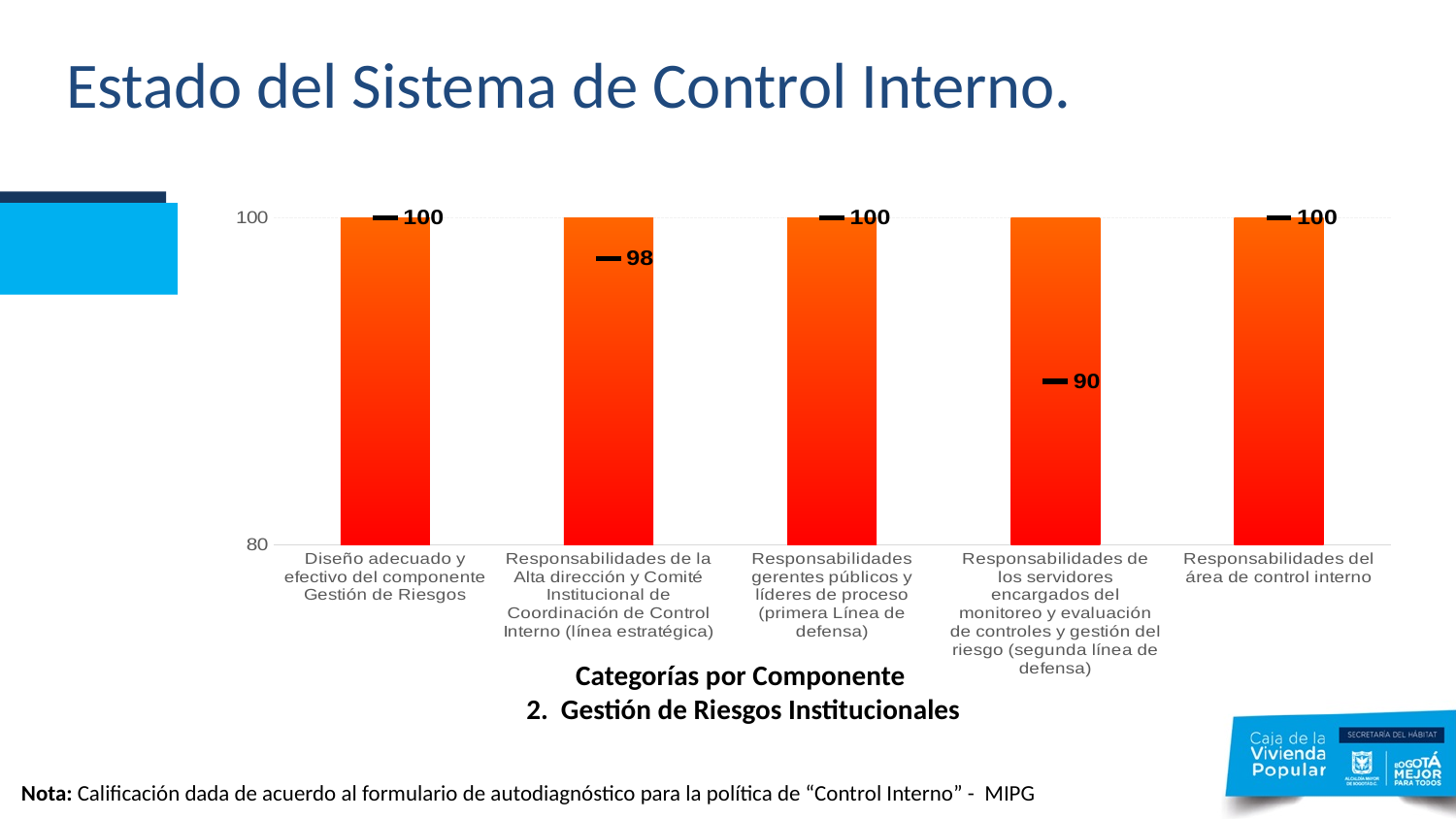
What type of chart is shown on the slide? bar chart How many categories are plotted in the chart? 5 What is the value for "Responsabilidades del área de control interno"? 100 How many categories in the chart have a value of 100? 3 What is the value for "Responsabilidades de la Alta dirección y Comité Institucional de Coordinación de Control Interno (línea estratégica)"? 98 What is the value for "Diseño adecuado y efectivo del componente Gestión de Riesgos"? 100 What is the difference between the value for "Responsabilidades de la Alta dirección y Comité Institucional de Coordinación de Control Interno (línea estratégica)" and the value for "Responsabilidades de los servidores encargados del monitoreo y evaluación de controles y gestión del riesgo (segunda línea de defensa)"? 8 Which is larger: the value for "Responsabilidades gerentes públicos y líderes de proceso (primera Línea de defensa)" or the value for "Responsabilidades de los servidores encargados del monitoreo y evaluación de controles y gestión del riesgo (segunda línea de defensa)"? Responsabilidades gerentes públicos y líderes de proceso (primera Línea de defensa) What is the lowest value shown on the vertical axis of the chart? 80 Which category has the lowest value in the chart? Responsabilidades de los servidores encargados del monitoreo y evaluación de controles y gestión del riesgo (segunda línea de defensa) What is the value for "Responsabilidades de los servidores encargados del monitoreo y evaluación de controles y gestión del riesgo (segunda línea de defensa)"? 90 What is the title of the slide? Estado del Sistema de Control Interno.